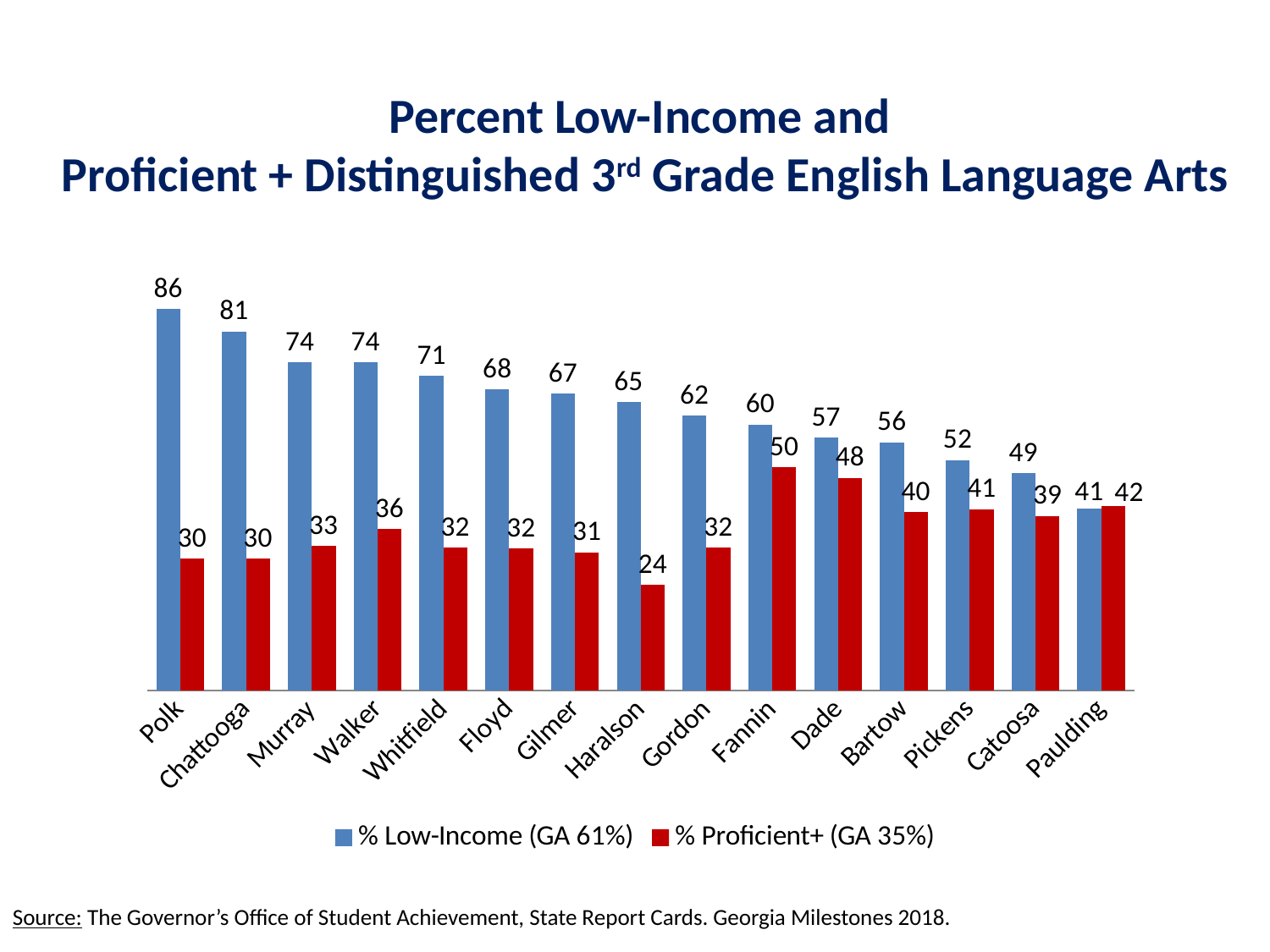
Which county has the highest % Low-Income value? Polk What Georgia statewide value is given in the legend for % Proficient+? 35% What is the % Proficient+ value for Haralson? 24 Which is larger for Paulding: % Low-Income or % Proficient+? % Proficient+ What is the % Proficient+ value for Fannin? 50 How many counties are shown on the x axis? 15 Do the % Low-Income values rise or fall from Polk to Paulding along the x axis? Fall What is the difference between the % Low-Income and % Proficient+ values for Chattooga? 51 Which county has the lowest % Proficient+ value? Haralson What kind of chart is shown on the slide? Bar chart How many series does the legend list? 2 What is the % Low-Income value for Polk? 86